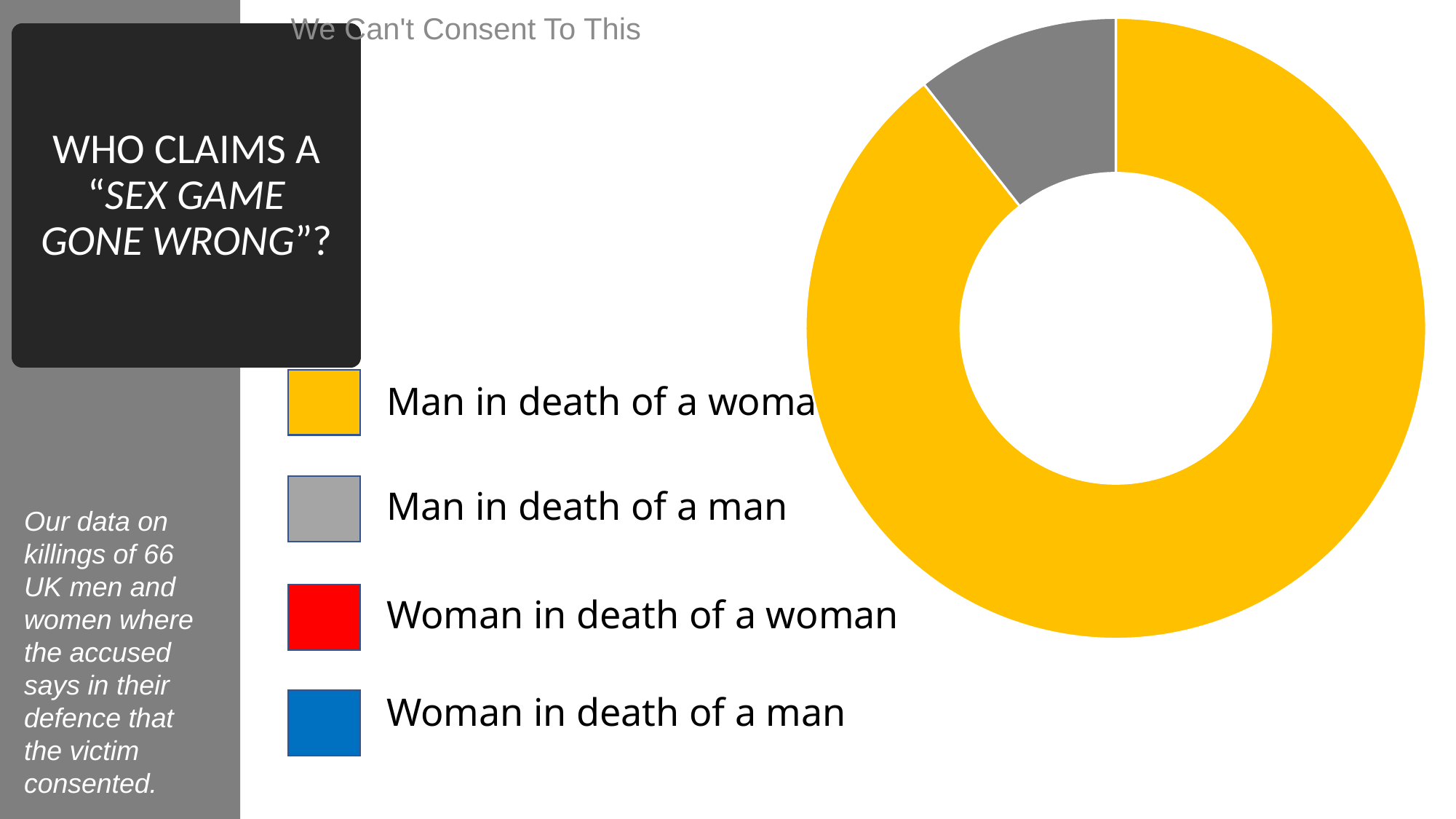
Which colour represents "Man in death of a man" in the chart? Grey Does the "Man in death of a woman" slice take up more or less than half of the doughnut chart? More Which category takes up the largest share of the doughnut chart? Man in death of a woman What kind of chart is shown on the slide? Doughnut chart How many entries does the chart's legend list? 4 How many slices are visibly drawn in the doughnut chart? 2 Which legend entry is shown in red? Woman in death of a woman Which is larger in the doughnut chart: the share for "Man in death of a woman" or the share for "Man in death of a man"? Man in death of a woman